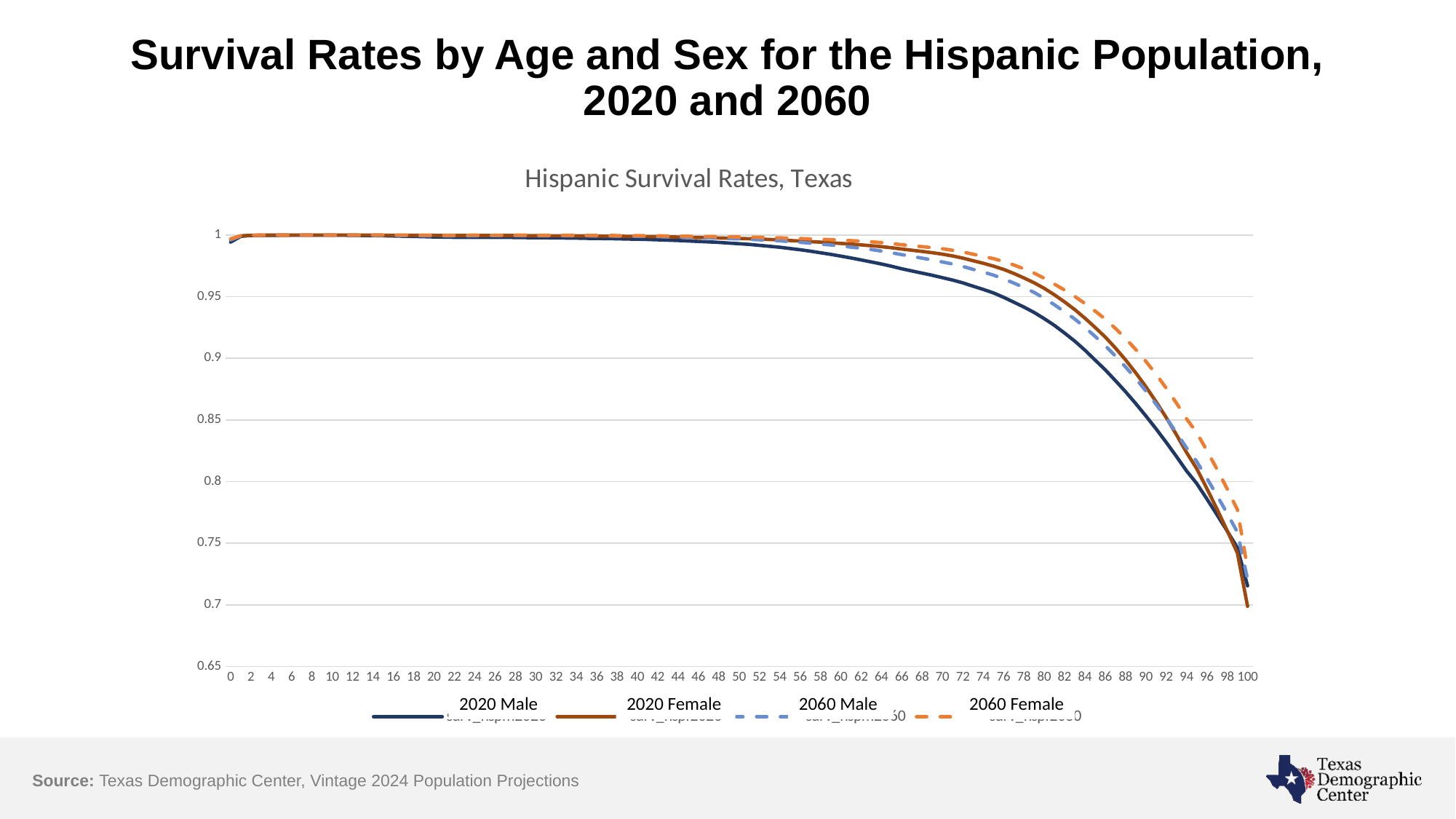
Is the value for 2020 Male at age 88 greater or less than 0.9? less At age 90, which is higher: 2020 Male or 2060 Female? 2060 Female At age 80, which is higher: 2020 Male or 2020 Female? 2020 Female What is the title printed above the chart's plot area? Hispanic Survival Rates, Texas Is the value for 2060 Female at age 90 greater or less than 0.85? greater Is the value for 2060 Female at age 80 greater or less than 0.95? greater Do the survival rates rise or fall as age increases along the x axis? fall How many series does the legend list? 4 Which series has the lowest survival rate at age 80? 2020 Male Which series are drawn with dashed lines? 2060 Male and 2060 Female What kind of chart is shown on the slide? line chart